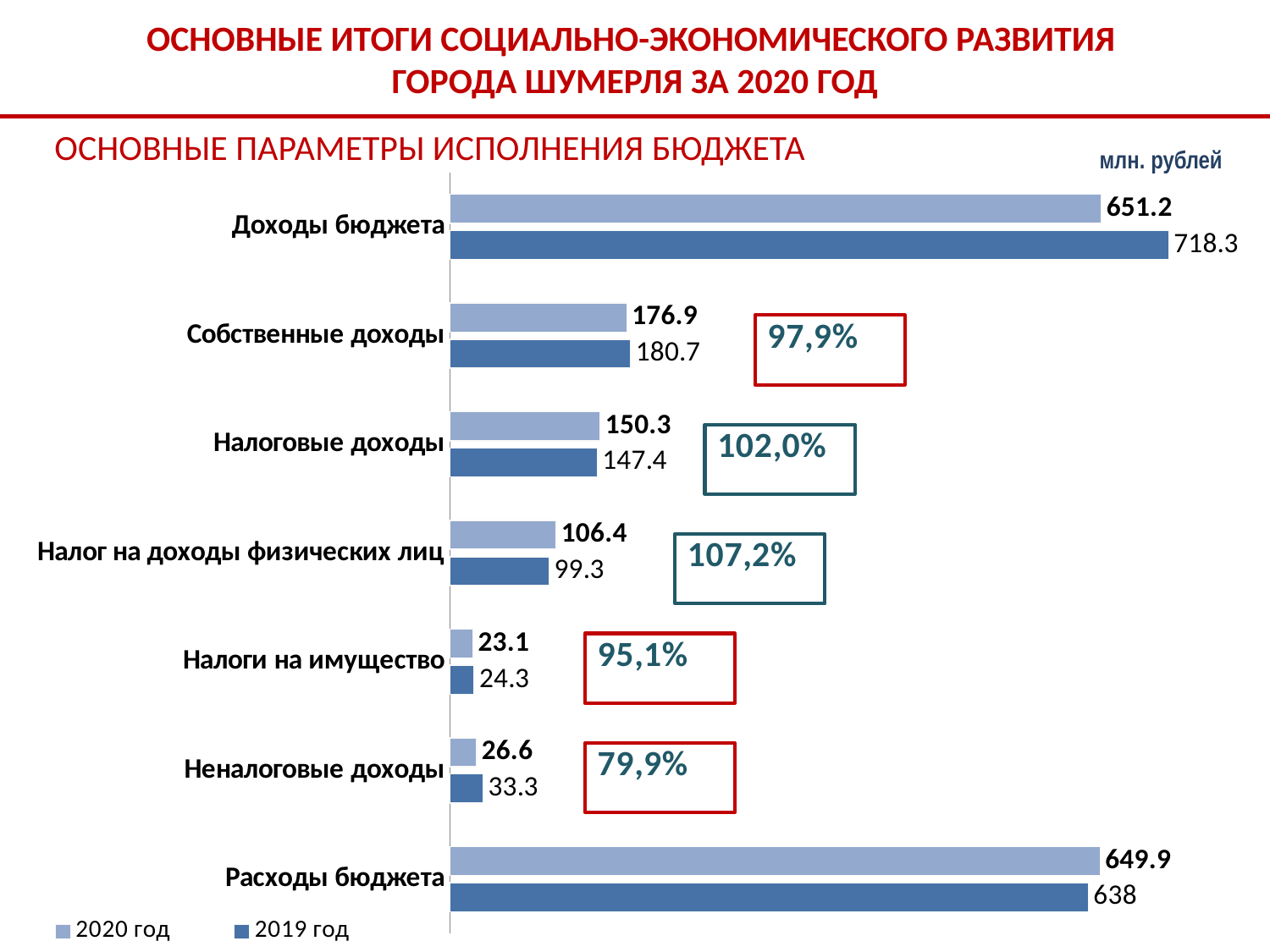
What is the value for Неналоговые доходы in the 2019 год series? 33.3 Which is larger for Собственные доходы: the 2020 год value or the 2019 год value? 2019 год What is the value for Расходы бюджета in the 2019 год series? 638 Which category has the highest value in the 2019 год series? Доходы бюджета Which category has the lowest value in the 2020 год series? Налоги на имущество How many series does the legend list? 2 What is the value for Налог на доходы физических лиц in the 2020 год series? 106.4 What kind of chart is shown on the slide? Bar chart What is the difference between the 2020 год and 2019 год values for Налоговые доходы? 2.9 What is the value for Доходы бюджета in the 2020 год series? 651.2 What is the difference between the 2019 год and 2020 год values for Доходы бюджета? 67.1 How many categories are shown on the chart? 7